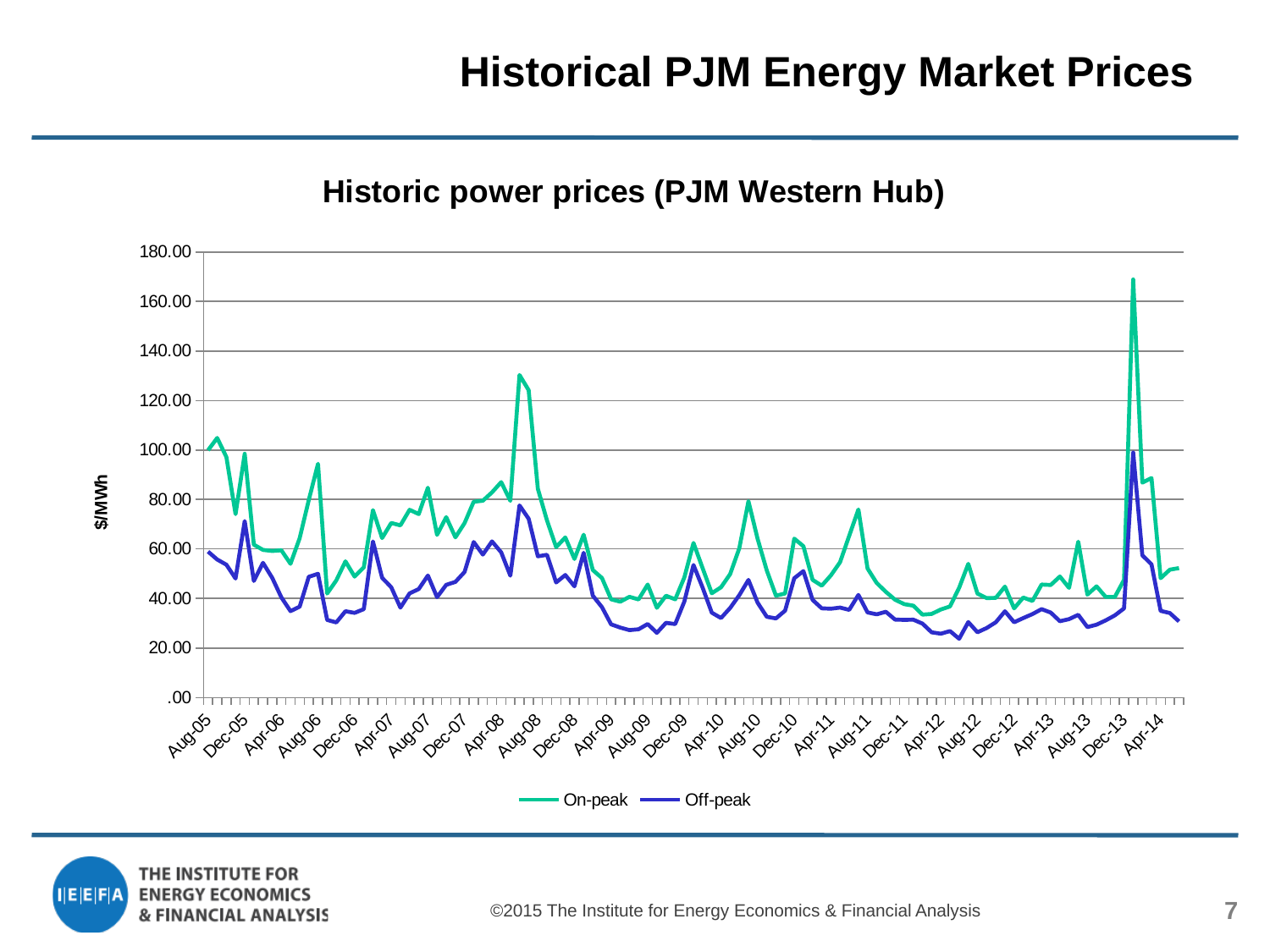
How many series does the legend list? 2 What is the title of the chart? Historic power prices (PJM Western Hub) Which series reaches the highest value on the chart? On-peak Is the On-peak value around Jun-08 greater or less than 120? greater At Aug-05, which series has the larger value, On-peak or Off-peak? On-peak Does the On-peak series rise or fall between Aug-05 and Apr-06? fall Is the highest value of the On-peak series greater or less than 160? greater What unit is shown on the y-axis label? $/MWh What kind of chart is shown on the slide? Line chart What is the last date label shown on the x-axis? Apr-14 Is the highest value of the Off-peak series greater or less than 80? greater